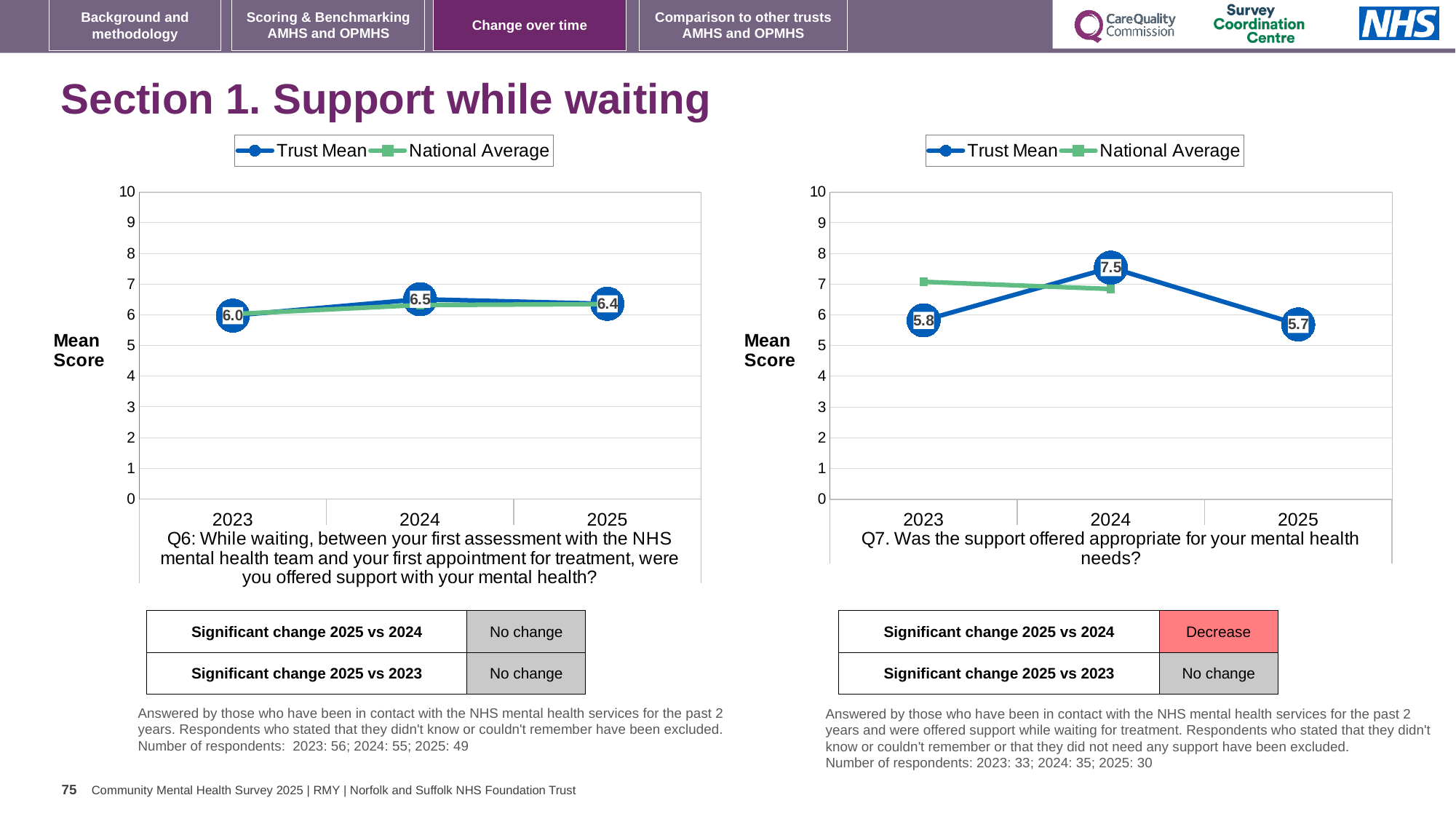
How many years are plotted on the x axis of the Q6 chart on the left? 3 In the Q7 chart on the right, which year has the highest Trust Mean? 2024 In the Q6 chart on the left, what is the Trust Mean for 2023? 6.0 In the Q7 chart on the right, is the National Average for 2023 greater or less than 6? greater In the Q6 chart on the left, what is the difference between the Trust Mean for 2024 and the Trust Mean for 2023? 0.5 What kind of chart is the Q6 chart on the left? Line chart In the Q6 chart on the left, is the Trust Mean for 2025 larger or smaller than the Trust Mean for 2023? larger In the Q7 chart on the right, what is the Trust Mean for 2025? 5.7 How many series does the legend of the Q7 chart on the right list? 2 In the Q7 chart on the right, what is the difference between the Trust Mean for 2024 and the Trust Mean for 2025? 1.8 In the Q6 chart on the left, what is the Trust Mean for 2024? 6.5 In the Q7 chart on the right, which year has the lowest Trust Mean? 2025